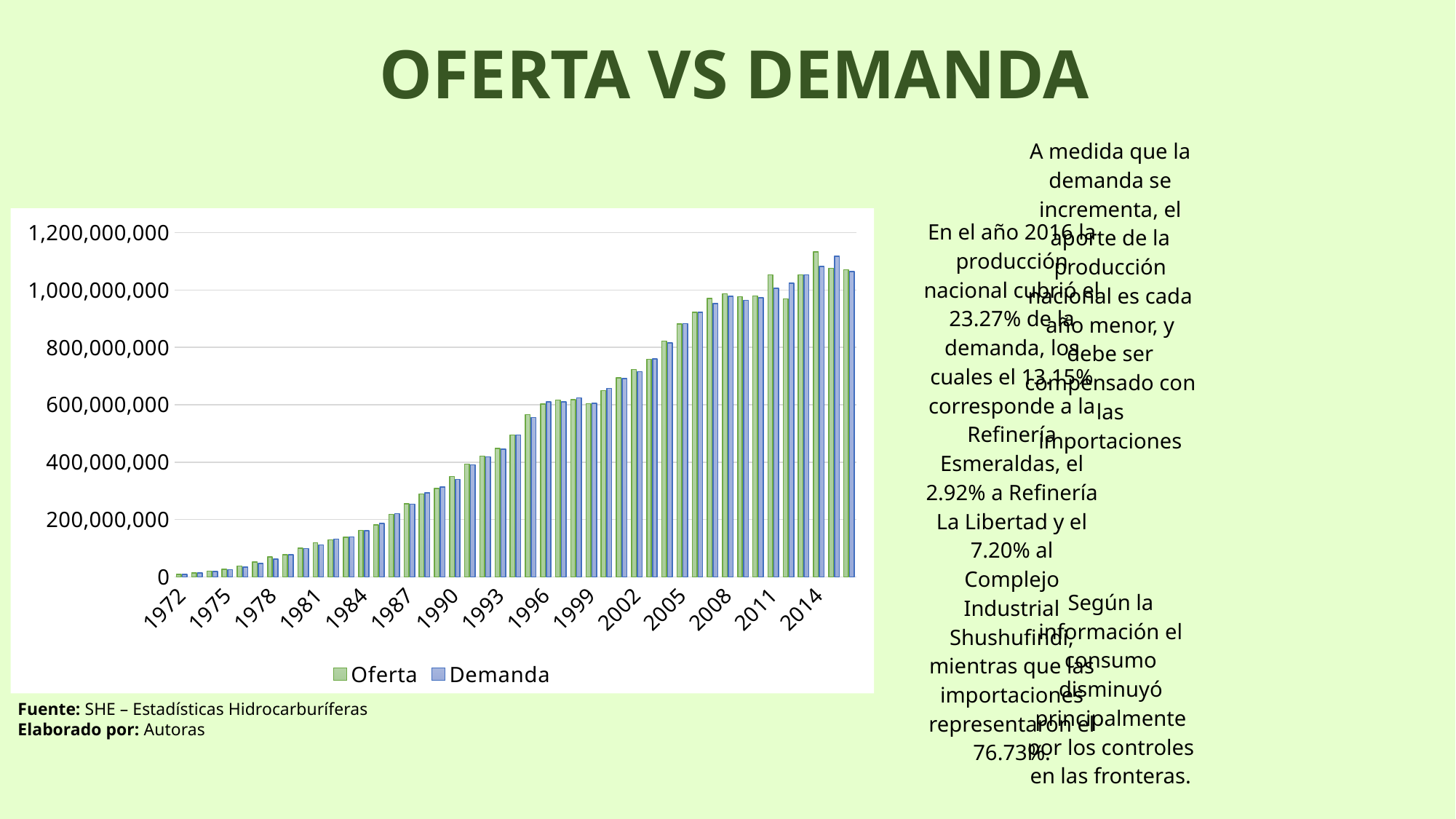
What is the title of the slide containing the chart? OFERTA VS DEMANDA What kind of chart is shown on the slide? bar chart Is the Demanda value for 2005 greater or less than 800,000,000? greater Do the Oferta values generally rise or fall from 1972 to 2014? rise Which year has the lowest Oferta value? 1972 Is the Demanda value for 1990 greater or less than 400,000,000? less Is the Oferta value for 2002 greater or less than 600,000,000? greater Which is larger, the Oferta value for 2014 or the Oferta value for 1972? 2014 What are the two series named in the legend? Oferta and Demanda How many series does the legend list? 2